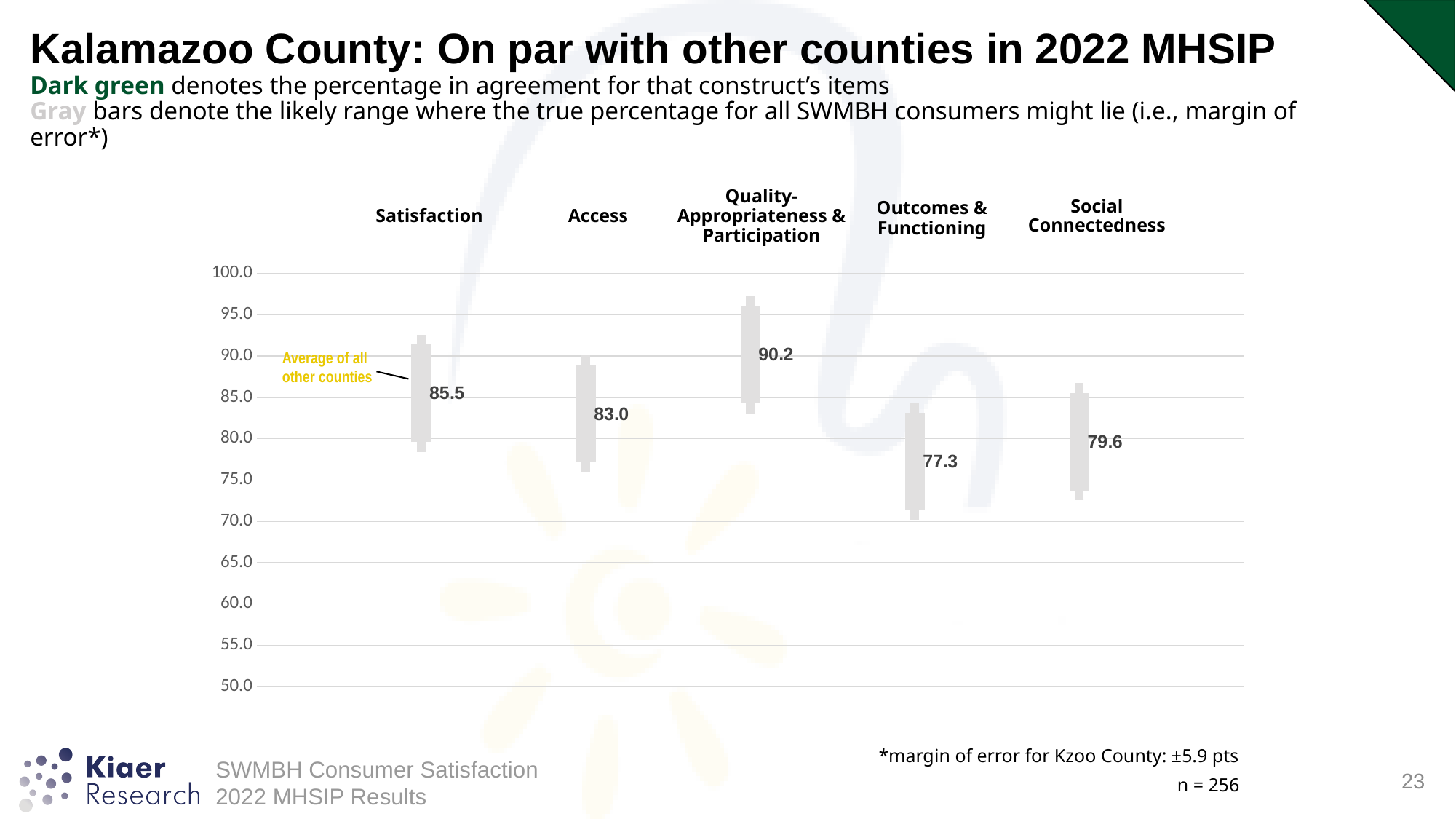
How many constructs are shown on the chart? 5 What is the value shown for Outcomes & Functioning? 77.3 Which construct has the lowest labeled value? Outcomes & Functioning What is the value shown for Satisfaction? 85.5 What is the value shown for Quality-Appropriateness & Participation? 90.2 What is the difference between the Satisfaction value and the Access value? 2.5 Which construct has the highest labeled value? Quality-Appropriateness & Participation Which is larger, the value for Social Connectedness or the value for Outcomes & Functioning? Social Connectedness What is the value shown for Social Connectedness? 79.6 What is the lowest value shown on the vertical axis? 50.0 According to the slide, what do the gray bars denote? The likely range where the true percentage for all SWMBH consumers might lie (margin of error) What is the value shown for Access? 83.0